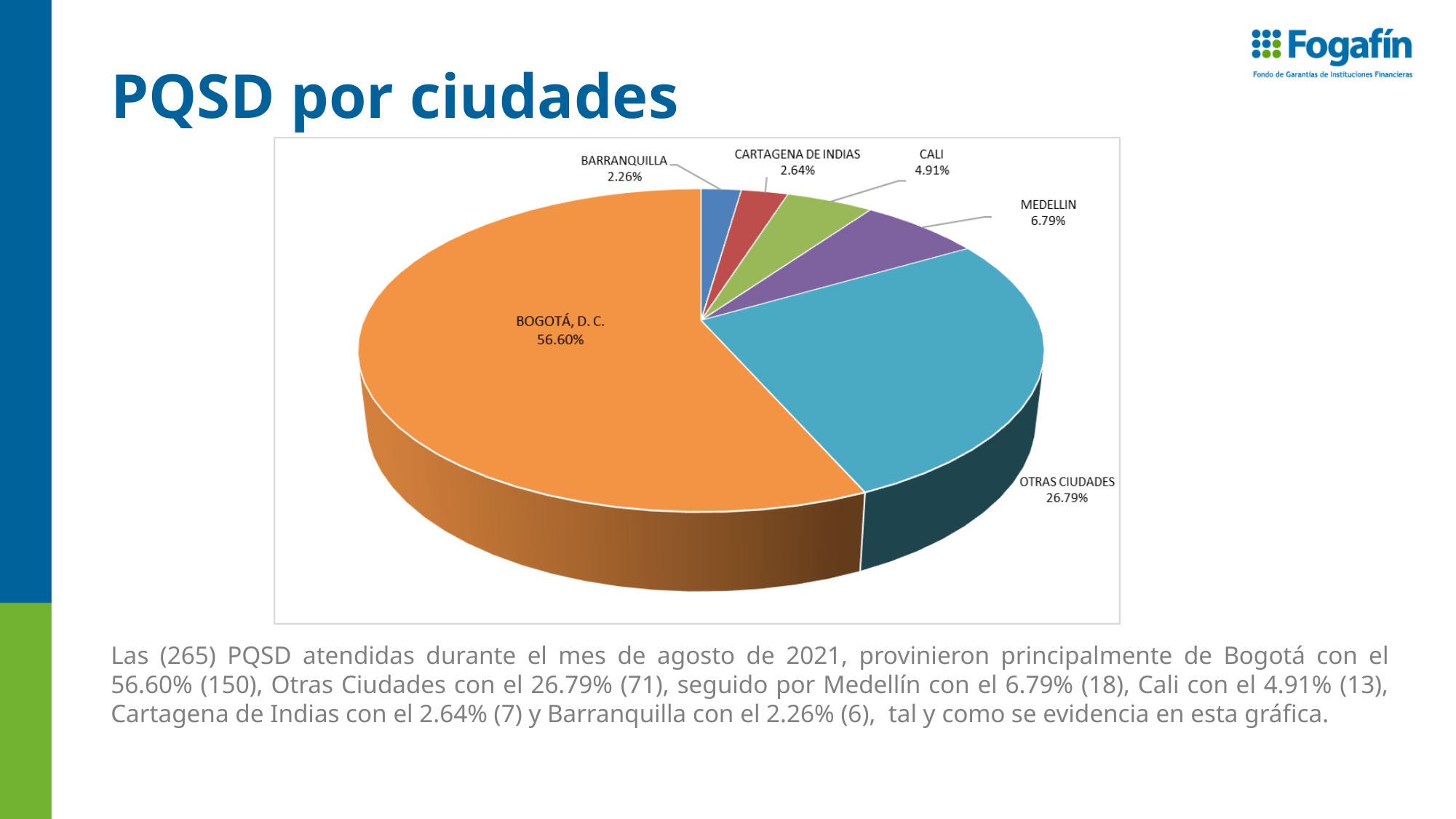
What colour is the BOGOTÁ, D. C. slice? Orange What percentage is shown for CALI? 4.91% What percentage is shown for OTRAS CIUDADES? 26.79% How many slices does the pie chart have? 6 Which is larger, the share for CALI or the share for MEDELLIN? MEDELLIN What percentage is shown for CARTAGENA DE INDIAS? 2.64% What is the difference in percentage points between BOGOTÁ, D. C. and OTRAS CIUDADES? 29.81 What percentage is shown for MEDELLIN? 6.79% Which category has the largest slice of the pie? BOGOTÁ, D. C. What share of the pie does BOGOTÁ, D. C. represent? 56.60% Which city has the smallest slice of the pie? BARRANQUILLA What kind of chart is shown on the slide? Pie chart